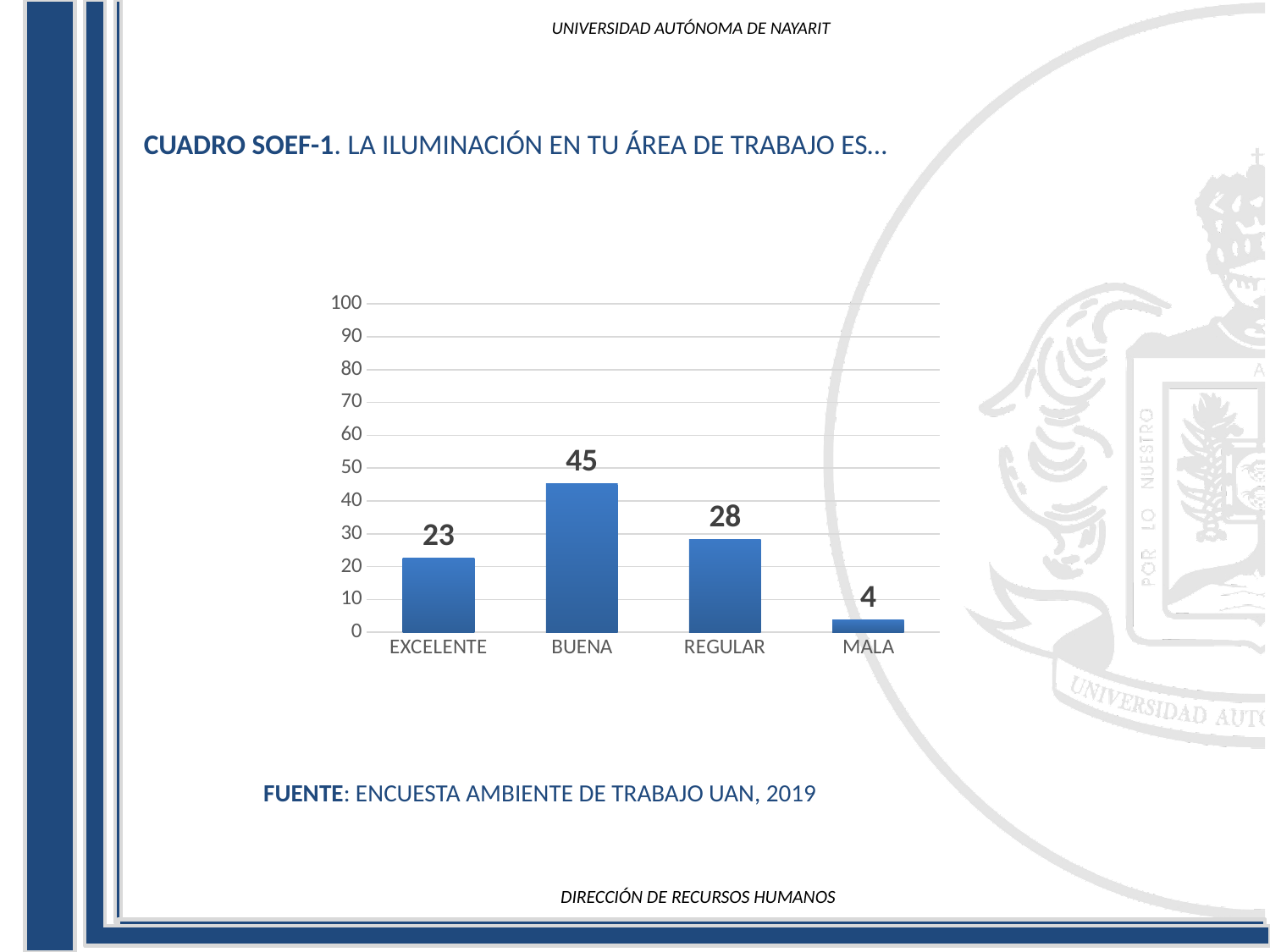
What is the value for EXCELENTE? 23 Which is larger, the value for EXCELENTE or the value for REGULAR? REGULAR What is the maximum value shown on the vertical axis? 100 What is the value for REGULAR? 28 How many categories are shown on the x axis? 4 What is the difference between the values for BUENA and REGULAR? 17 What is the value for MALA? 4 Is the value for BUENA greater or less than 40? greater What kind of chart is shown on the slide? bar chart What is the value for BUENA? 45 Which category has the lowest value? MALA Which category has the highest value? BUENA